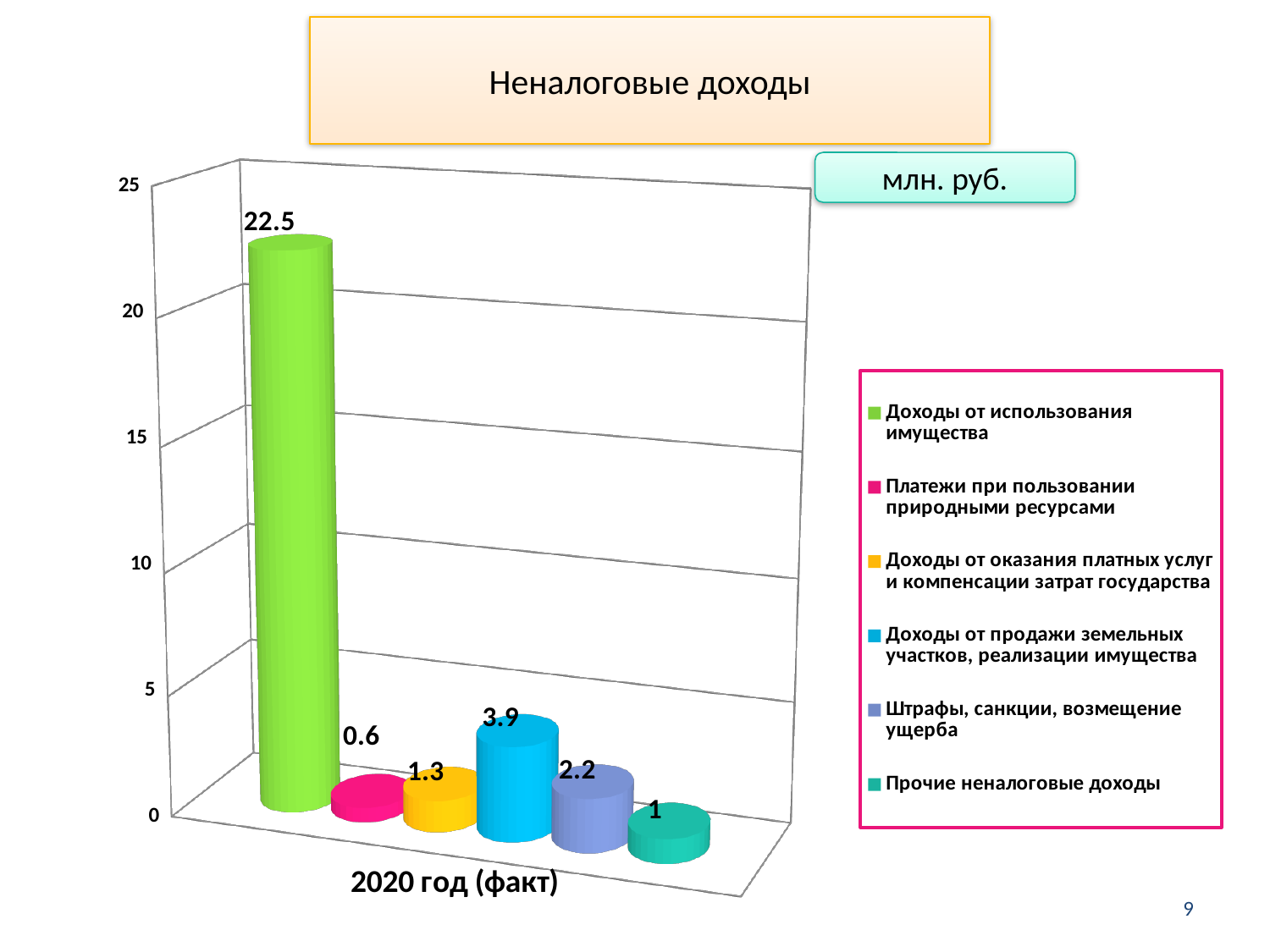
Which series has the highest value? Доходы от использования имущества What is the value for Прочие неналоговые доходы? 1 What is the value for Штрафы, санкции, возмещение ущерба? 2.2 Which series has the lowest value? Платежи при пользовании природными ресурсами What kind of chart is shown on the slide? Bar chart What unit is indicated for the chart values? млн. руб. Which is larger: Доходы от оказания платных услуг и компенсации затрат государства or Штрафы, санкции, возмещение ущерба? Штрафы, санкции, возмещение ущерба What is the value for Платежи при пользовании природными ресурсами? 0.6 What is the difference between Доходы от использования имущества and Доходы от продажи земельных участков, реализации имущества? 18.6 What is the value for Доходы от использования имущества in 2020 год (факт)? 22.5 How many series does the legend list? 6 What is the value for Доходы от продажи земельных участков, реализации имущества? 3.9